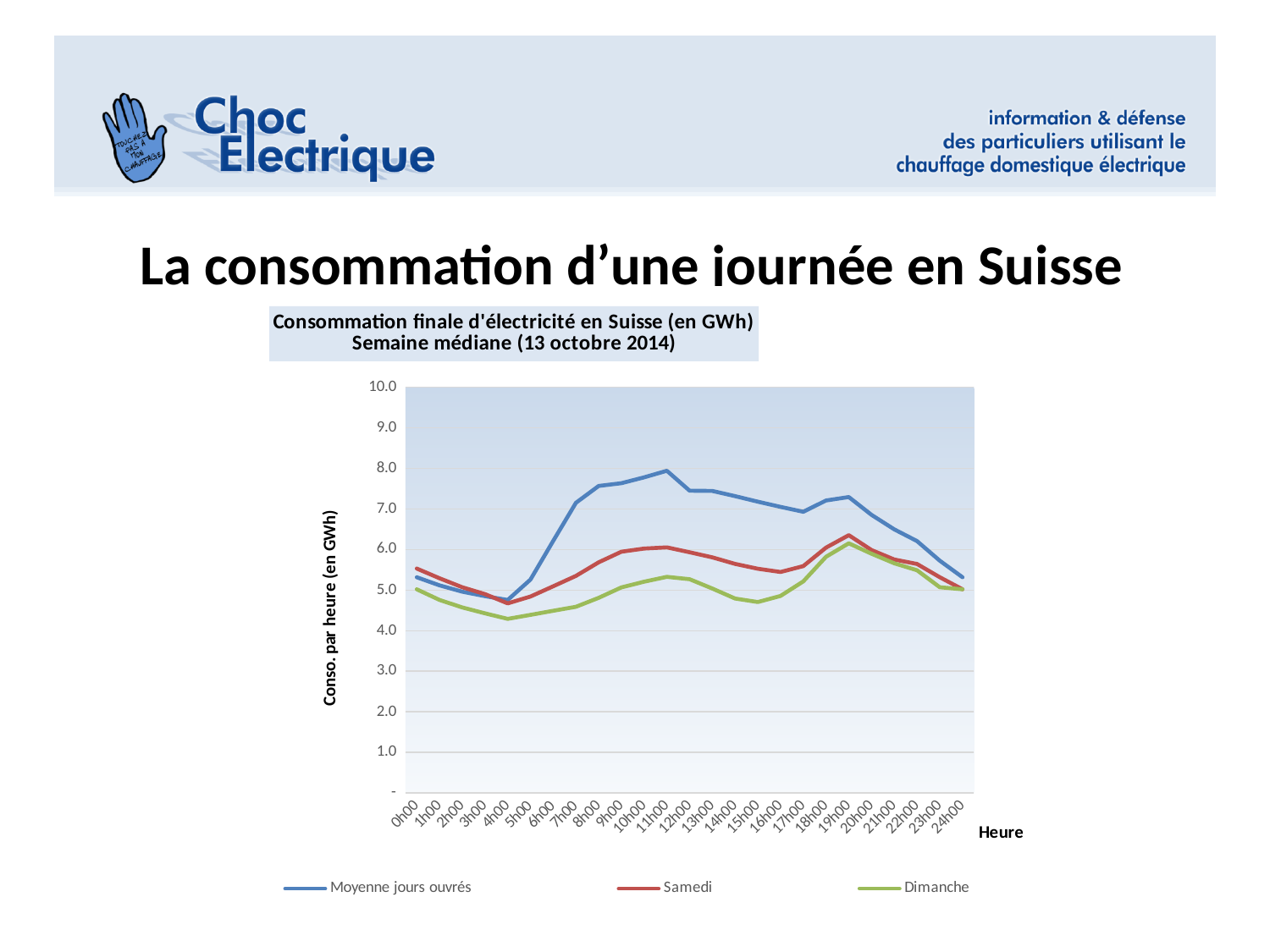
What kind of chart is shown on the slide? line chart How many series does the legend list? 3 Is the value for Dimanche at 15h00 greater or less than 5.0? less Is the value for Moyenne jours ouvrés at 11h00 greater or less than 7.0? greater At which hour does the Moyenne jours ouvrés series reach its highest value? 11h00 At 11h00, which series has the higher value, Moyenne jours ouvrés or Samedi? Moyenne jours ouvrés How many hourly points are shown along the x axis (from 0h00 to 24h00)? 25 Does the Moyenne jours ouvrés series rise or fall between 4h00 and 11h00? rise What is the label of the vertical axis? Conso. par heure (en GWh) At which hour does the Dimanche series reach its lowest value? 4h00 Which series has the lowest value at 9h00? Dimanche Is the value for Dimanche at 4h00 greater or less than 5.0? less